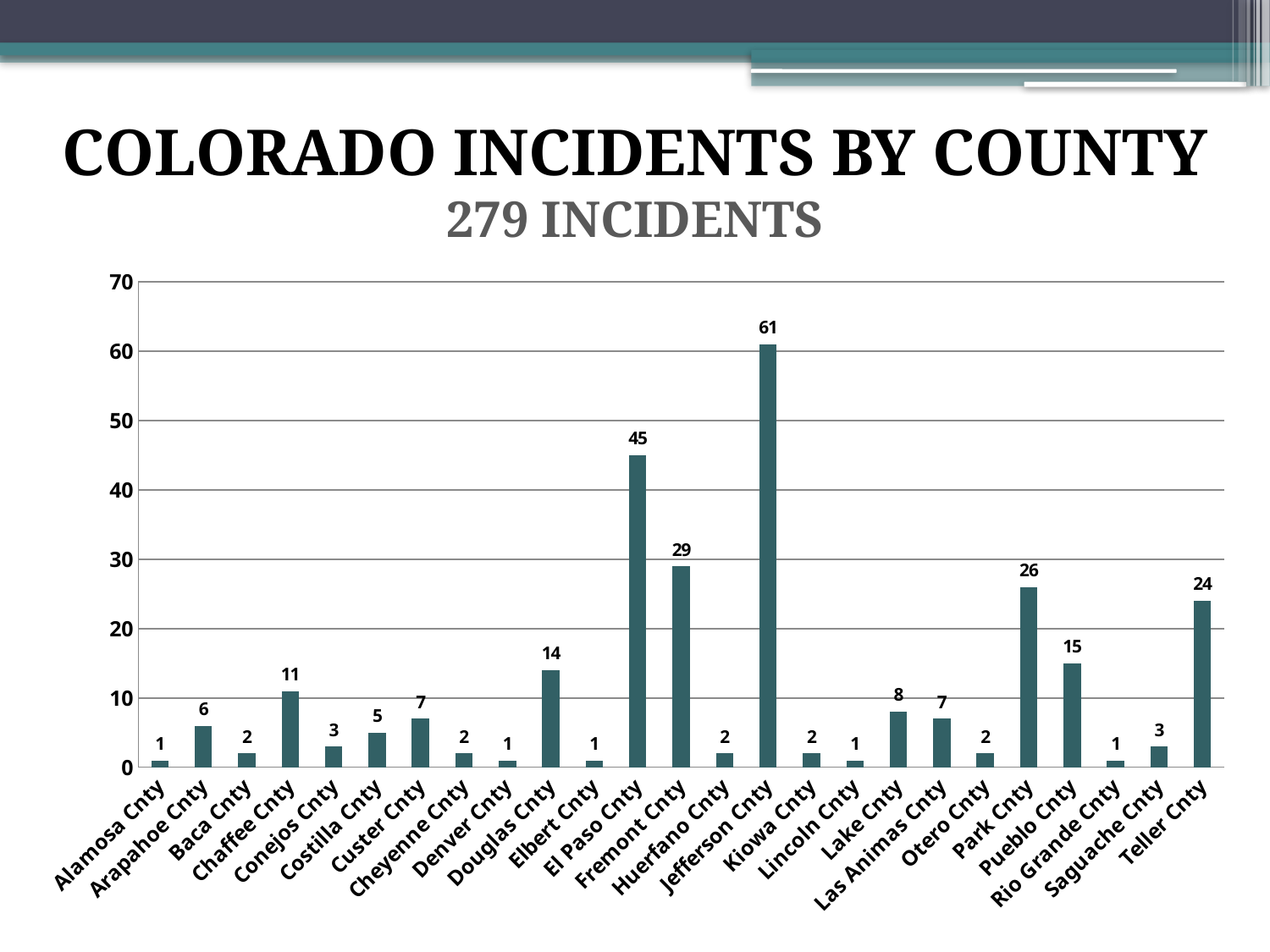
What is the difference in incidents between Jefferson Cnty and El Paso Cnty? 16 Which county has the highest number of incidents? Jefferson Cnty How many counties are shown on the x axis of the chart? 25 What is the number of incidents for Douglas Cnty? 14 What is the number of incidents for El Paso Cnty? 45 What is the number of incidents for Jefferson Cnty? 61 Which has more incidents, Chaffee Cnty or Lake Cnty? Chaffee Cnty What is the difference in incidents between Fremont Cnty and Pueblo Cnty? 14 What type of chart is shown on the slide? Bar chart Which has more incidents, Park Cnty or Teller Cnty? Park Cnty What is the number of incidents for Park Cnty? 26 Is the value for Fremont Cnty greater or less than 20? greater